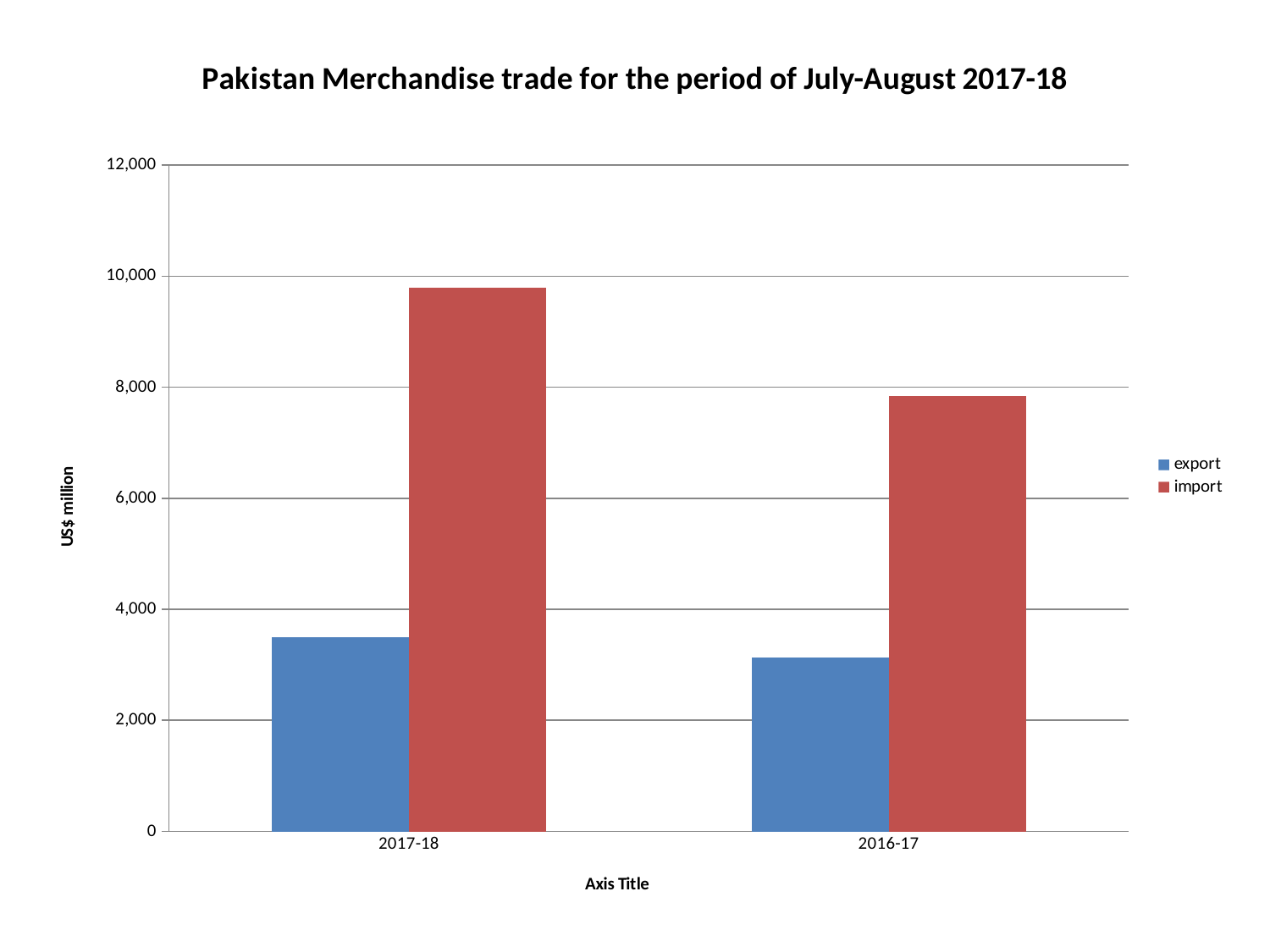
What is the title of the chart? Pakistan Merchandise trade for the period of July-August 2017-18 Is the export value for 2017-18 greater or less than 4,000? less Which period has the higher import value? 2017-18 Which period has the lower export value? 2016-17 How many categories are shown on the x axis? 2 Is the import value for 2016-17 greater or less than 6,000? greater Is the export value for 2016-17 greater or less than 2,000? greater What kind of chart is shown on the slide? bar chart What is the label on the vertical axis? US$ million Which is larger for 2017-18, export or import? import How many series does the legend list? 2